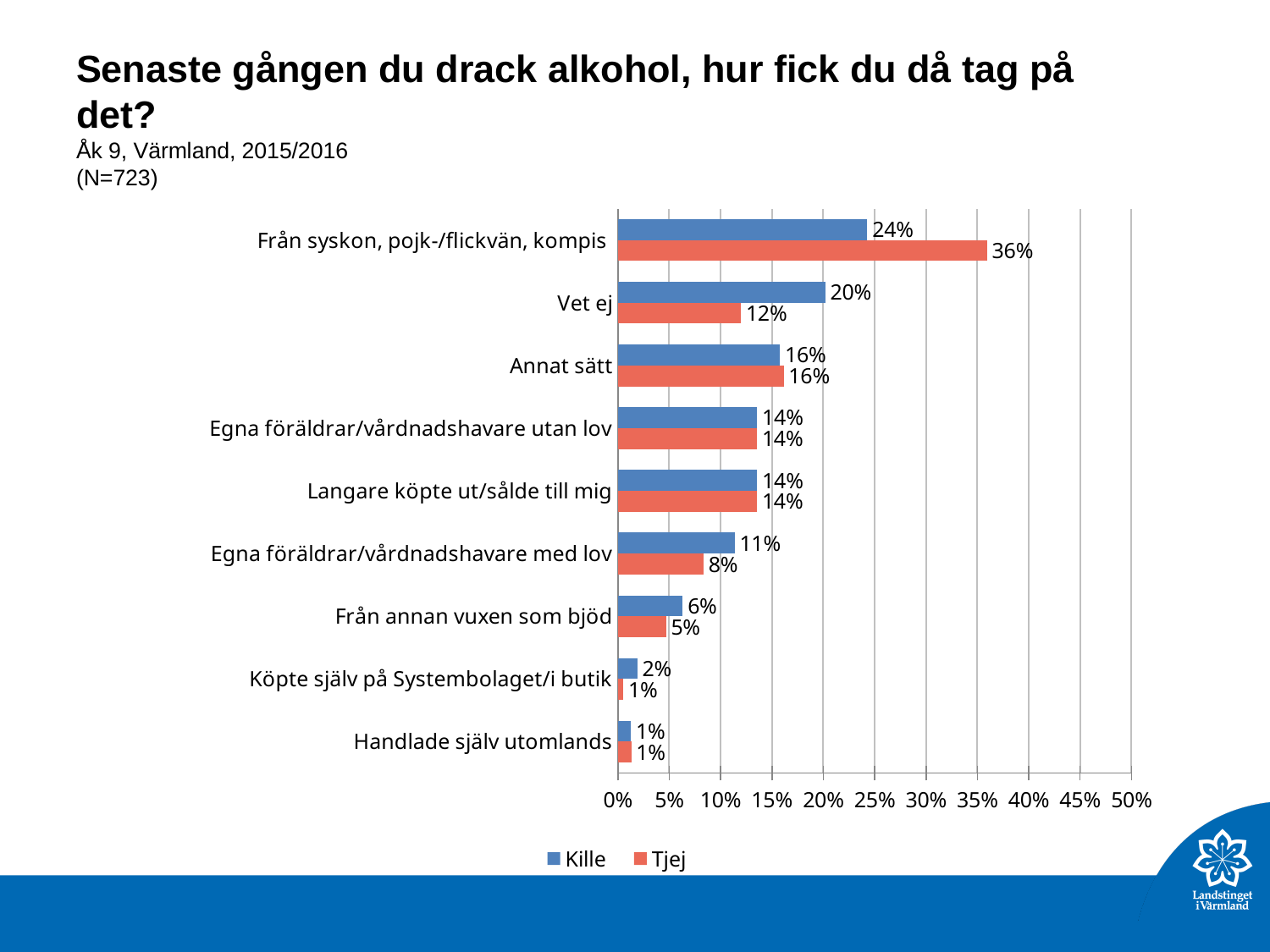
How many series does the legend list? 2 What kind of chart is shown on the slide? Bar chart How many categories are shown on the chart? 9 What is the value for Kille in the category "Vet ej"? 20% Which category has the lowest value for Kille? Handlade själv utomlands What is the difference between the Kille and Tjej values for "Vet ej"? 8% Which category has the highest value for Tjej? Från syskon, pojk-/flickvän, kompis What is the value for Tjej in the category "Från syskon, pojk-/flickvän, kompis"? 36% Which series is shown in red/orange according to the legend? Tjej What is the value for Tjej in the category "Egna föräldrar/vårdnadshavare med lov"? 8% What is the difference between the Tjej and Kille values for "Från syskon, pojk-/flickvän, kompis"? 12% Which is larger for "Från annan vuxen som bjöd": the Kille value or the Tjej value? Kille